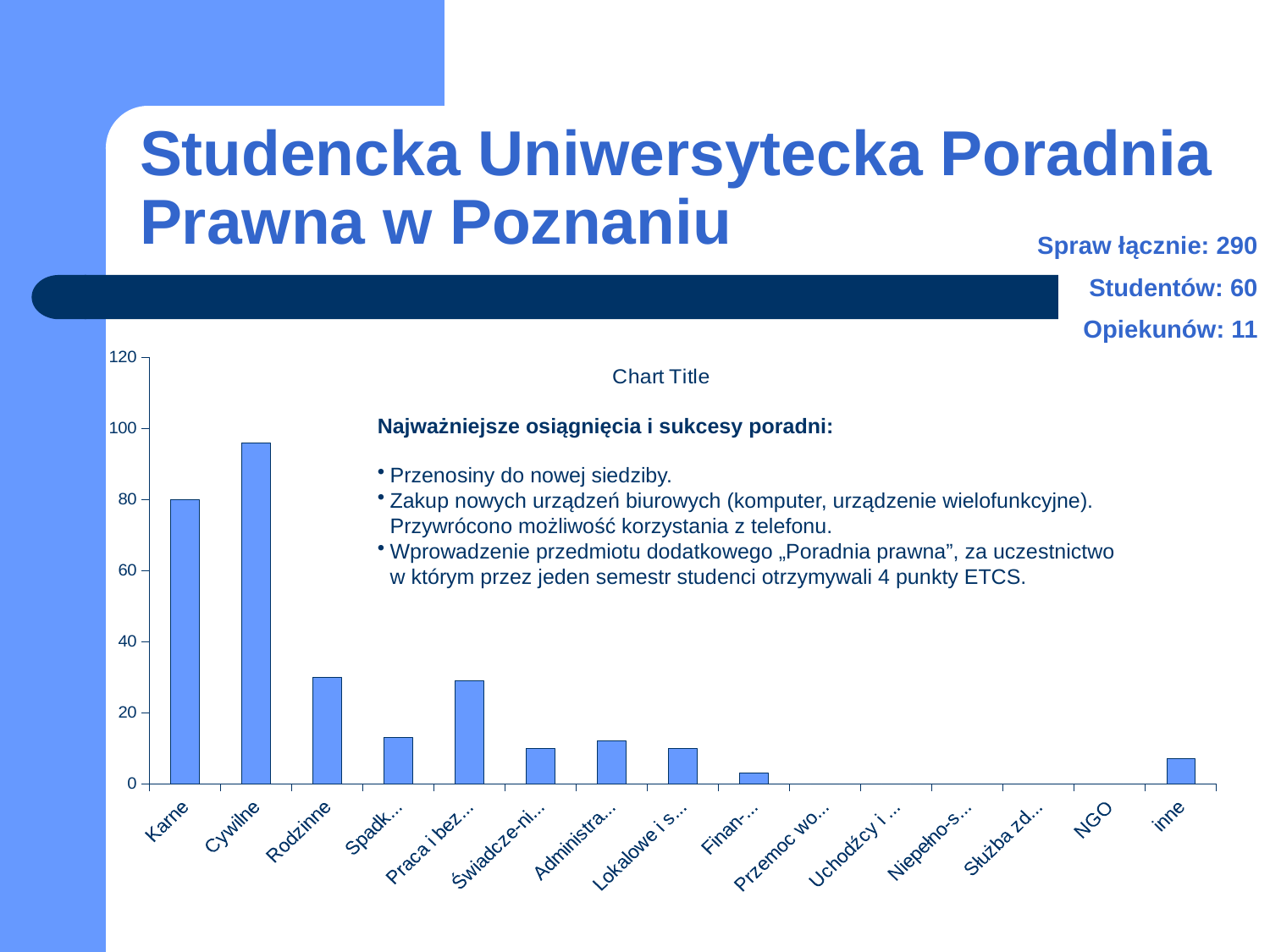
Is the value for Rodzinne greater or less than 40? less What kind of chart is shown on the slide? bar chart Is the value for Rodzinne greater or less than 20? greater Which is larger, the value for Karne or the value for Cywilne? Cywilne Is the value for Karne greater or less than 60? greater Which category has the highest bar in the chart? Cywilne How many categories are shown on the x axis of the chart? 15 Which is larger, the value for Rodzinne or the value for Karne? Karne What is the title shown on the chart? Chart Title